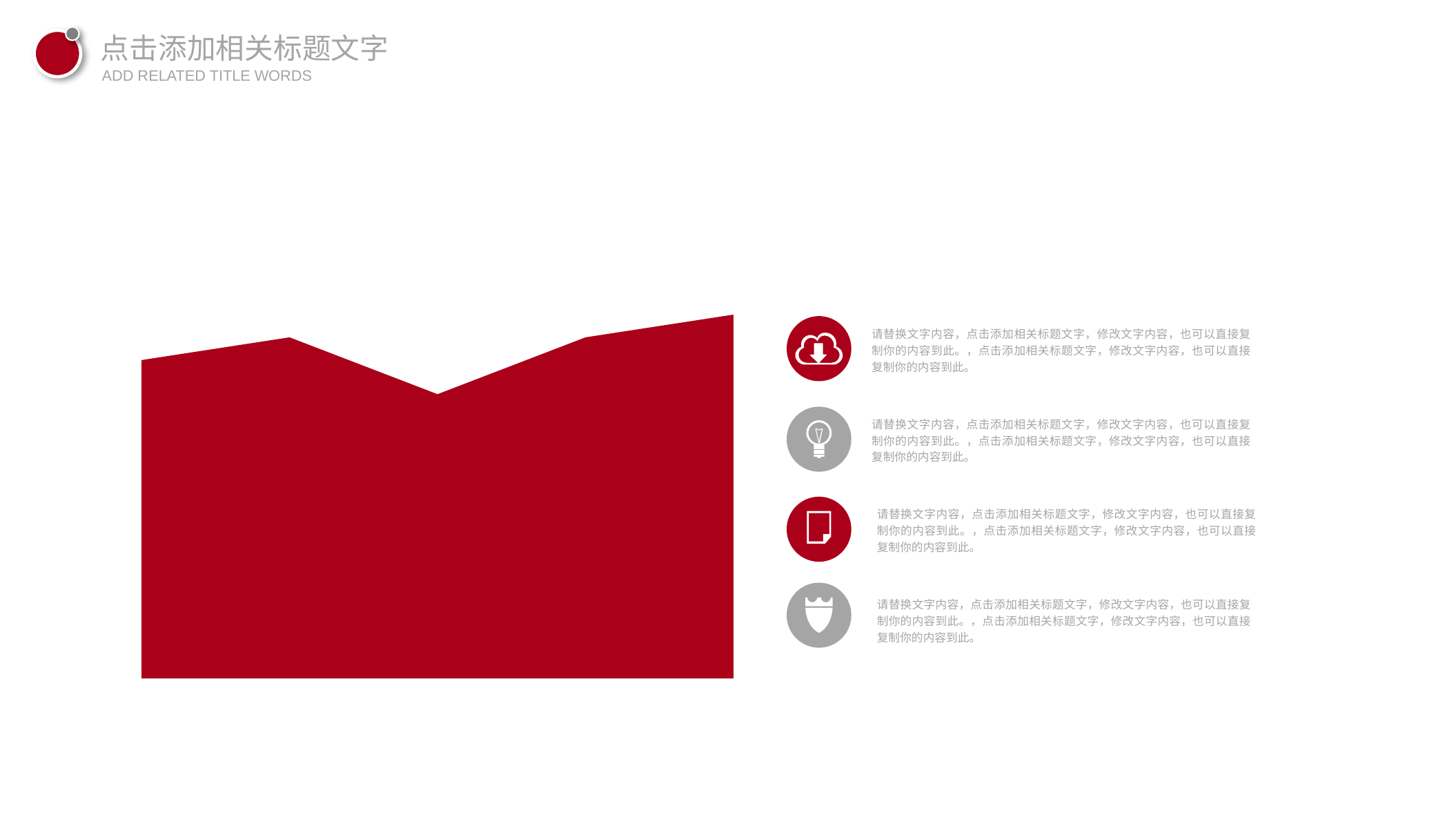
What colour is the area chart on the left filled with? red In the area chart on the left, which point is the lowest? the middle (third) point What kind of chart is shown on the left of the slide? area chart In the area chart on the left, which point is the highest? the last (fifth) point Does the area chart on the left show any axes or data labels? no How many data points does the area chart on the left plot? 5 In the area chart on the left, do the values rise or fall from the third point to the last point? rise In the area chart on the left, is the last point higher or lower than the first point? higher